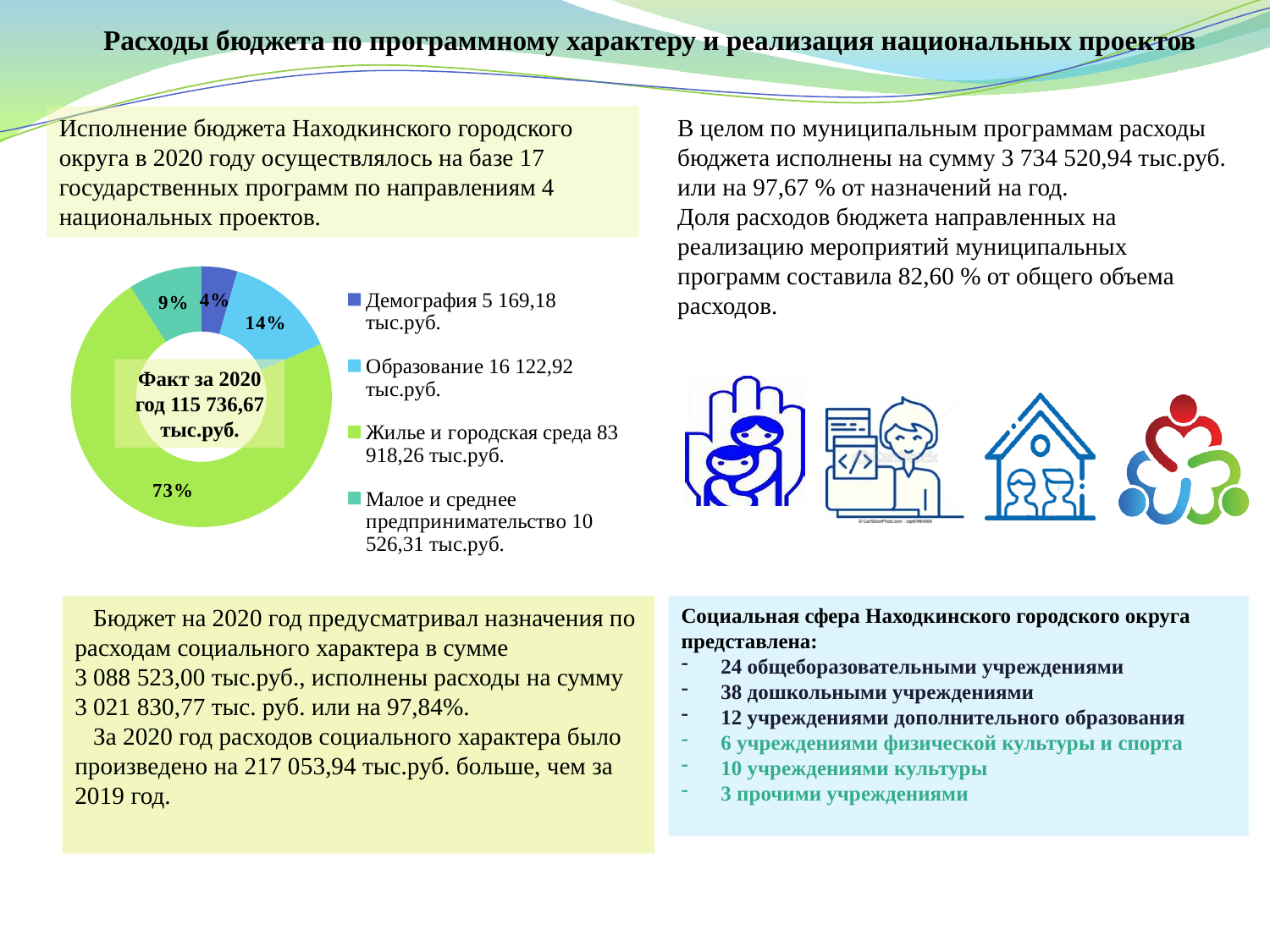
What kind of chart is shown on the slide? Doughnut (pie) chart What is the difference in percentage points between the shares of Жилье и городская среда and Образование? 59 How many slices does the doughnut chart have? 4 What percentage share does the slice for Жилье и городская среда have? 73% What total amount is printed in the centre of the doughnut chart? Факт за 2020 год 115 736,67 тыс.руб. Which has a larger share: Образование or Малое и среднее предпринимательство? Образование What value in тыс.руб. does the legend give for Образование? 16 122,92 тыс.руб. What percentage share does the slice for Демография have? 4% What percentage share does the slice for Образование have? 14% Which category has the smallest share of the doughnut chart? Демография Which category has the largest share of the doughnut chart? Жилье и городская среда